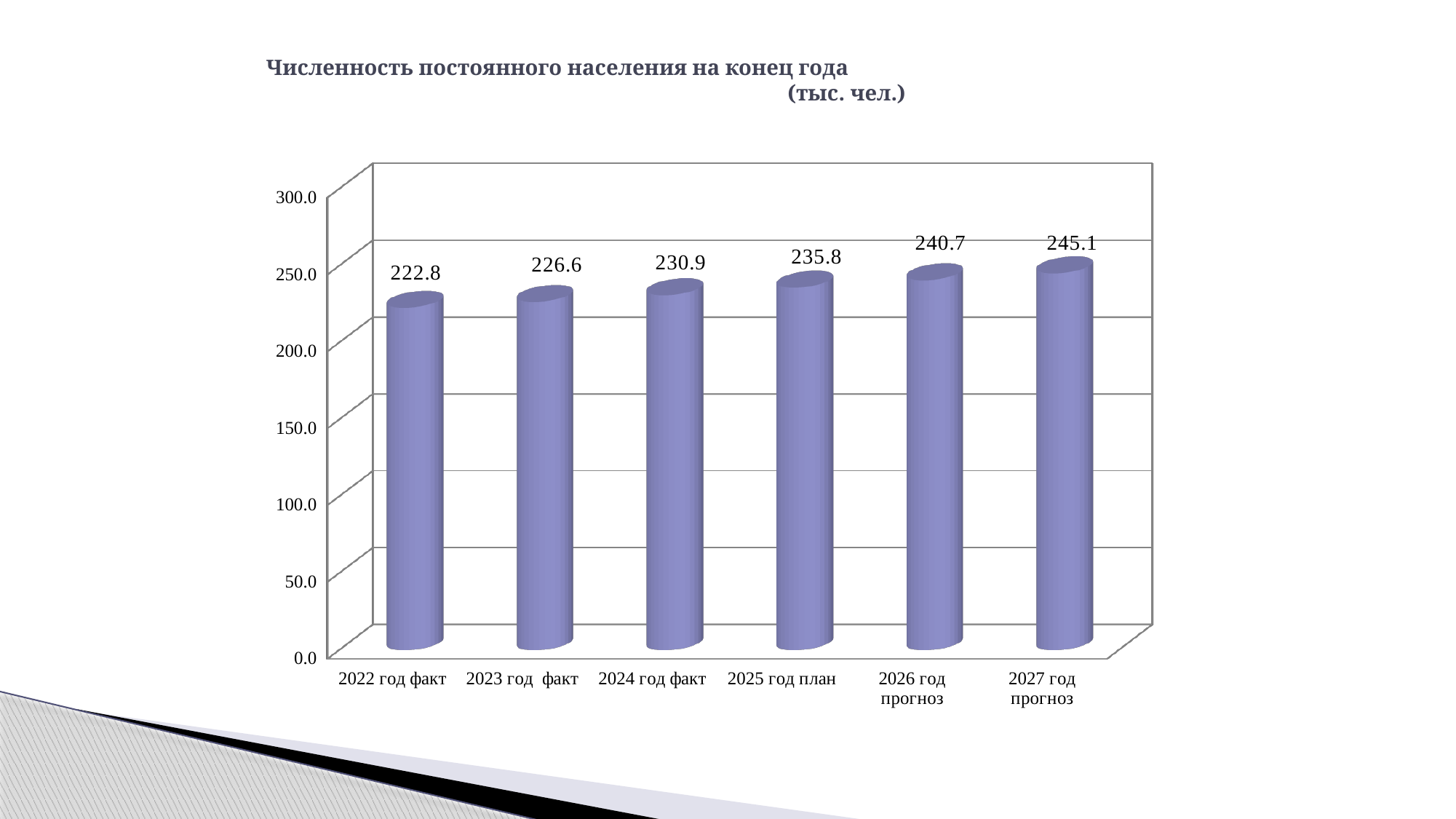
Do the values rise or fall from 2022 год факт to 2027 год прогноз? rise Which category has the highest value? 2027 год прогноз How many categories are shown on the x axis? 6 Which category has the lowest value? 2022 год факт What is the value for 2027 год прогноз? 245.1 What is the difference between the values for 2027 год прогноз and 2022 год факт? 22.3 What is the value for 2025 год план? 235.8 What kind of chart is shown on the slide? bar chart What is the difference between the values for 2024 год факт and 2023 год факт? 4.3 What is the value for 2022 год факт? 222.8 Is the value for 2023 год факт greater or less than 200.0? greater Which is larger, the value for 2026 год прогноз or the value for 2024 год факт? 2026 год прогноз